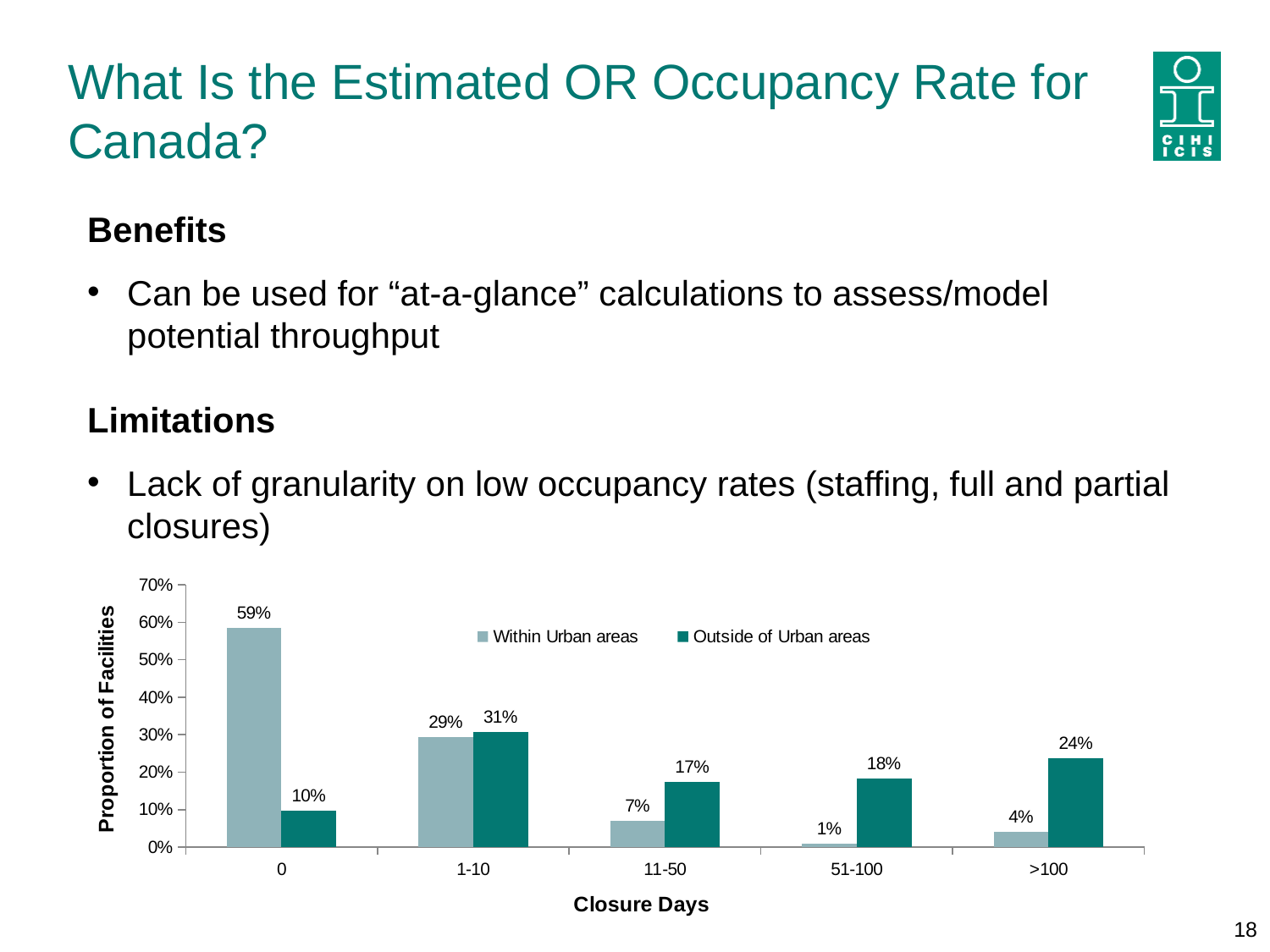
What kind of chart is shown on the slide? Bar chart Which closure days category has the highest value for Within Urban areas? 0 How many series does the legend list? 2 What is the value for Outside of Urban areas at 1-10 closure days? 31% What is the difference between Outside of Urban areas and Within Urban areas at 11-50 closure days? 10% How many closure days categories are shown on the x axis? 5 Is the value for Within Urban areas at 0 closure days greater or less than 50%? greater What is the label of the y axis? Proportion of Facilities Which closure days category has the lowest value for Outside of Urban areas? 0 Which is larger at 51-100 closure days: Within Urban areas or Outside of Urban areas? Outside of Urban areas What is the value for Outside of Urban areas at >100 closure days? 24% What is the value for Within Urban areas at 0 closure days? 59%